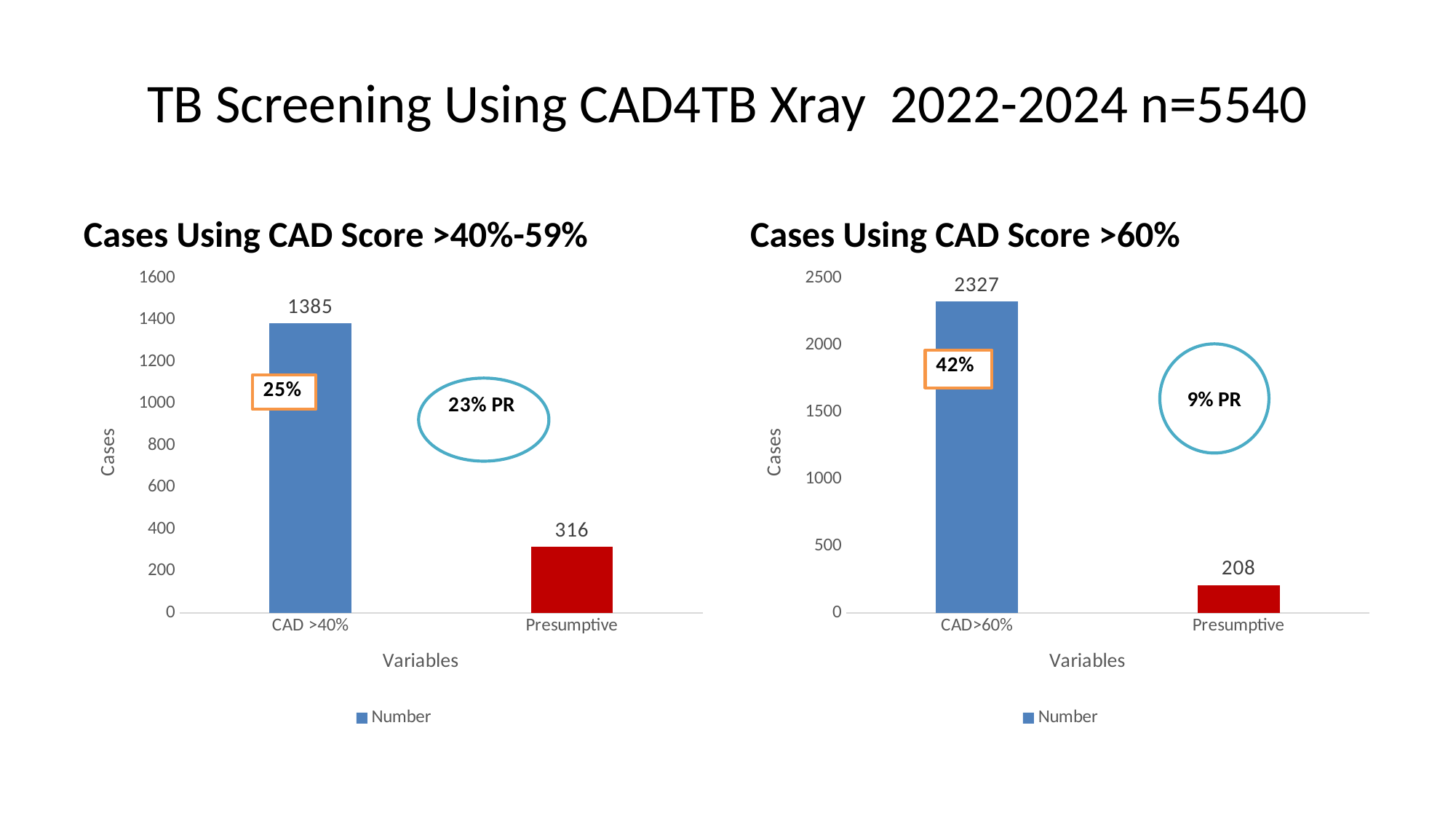
In the chart titled "Cases Using CAD Score >40%-59%", what is the value for CAD >40%? 1385 What kind of chart is the chart titled "Cases Using CAD Score >40%-59%"? bar chart What is the single legend entry shown below the chart titled "Cases Using CAD Score >60%"? Number In the chart titled "Cases Using CAD Score >60%", which category has the lowest value? Presumptive In the chart titled "Cases Using CAD Score >60%", what is the difference between the CAD>60% value and the Presumptive value? 2119 In the chart titled "Cases Using CAD Score >40%-59%", which category has the highest value? CAD >40% In the chart titled "Cases Using CAD Score >60%", what is the value for Presumptive? 208 Is the Presumptive value in the chart titled "Cases Using CAD Score >40%-59%" larger or smaller than the Presumptive value in the chart titled "Cases Using CAD Score >60%"? larger In the chart titled "Cases Using CAD Score >60%", what is the value for CAD>60%? 2327 How many categories are shown on the x axis of the chart titled "Cases Using CAD Score >60%"? 2 In the chart titled "Cases Using CAD Score >40%-59%", what is the difference between the CAD >40% value and the Presumptive value? 1069 In the chart titled "Cases Using CAD Score >40%-59%", what is the value for Presumptive? 316